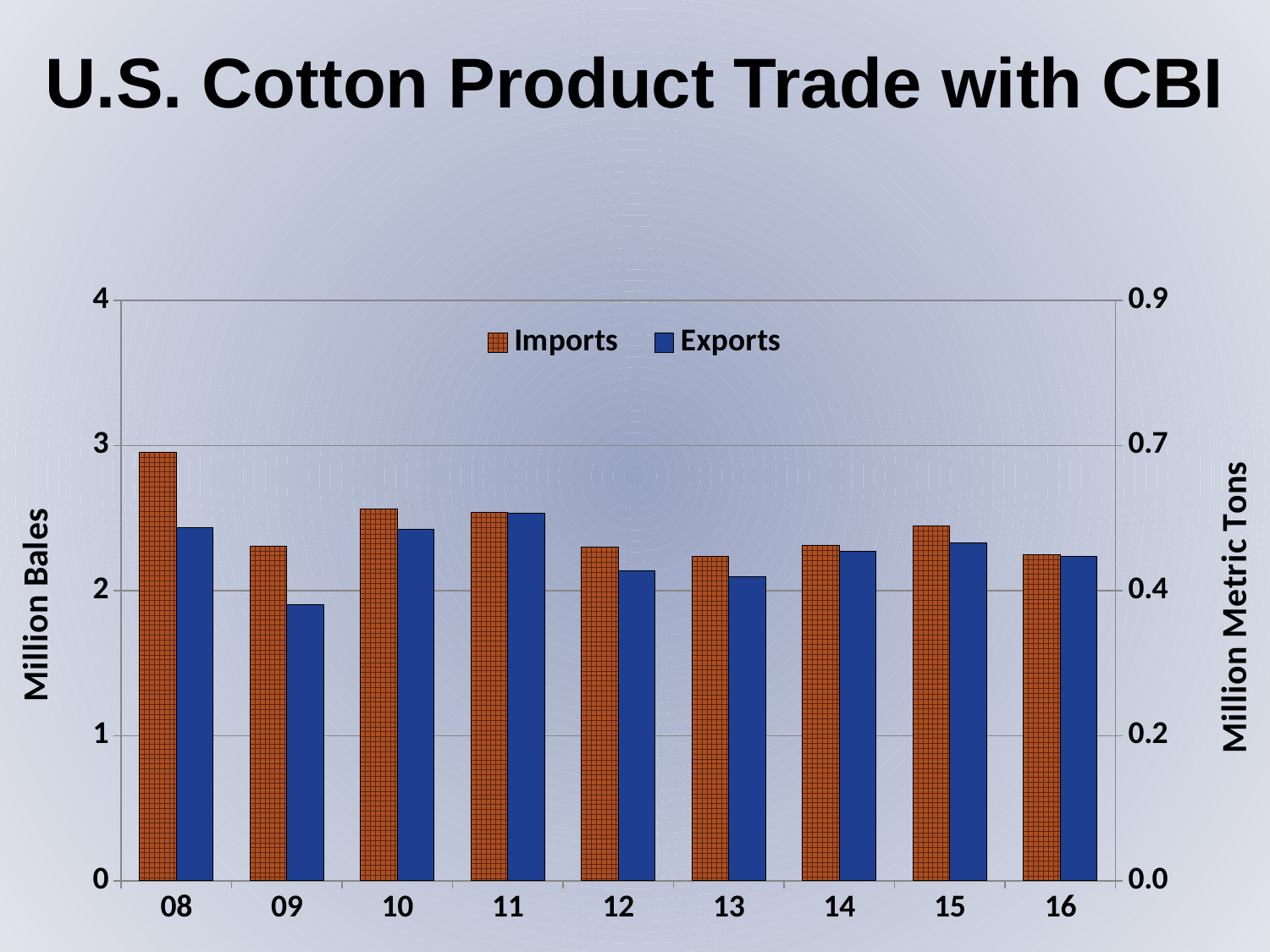
Is the value for Exports in 11 greater or less than 2 million bales? greater In 08, which is larger, Imports or Exports? Imports In which year are Exports lowest? 09 How many years are shown on the x axis? 9 Is the value for Exports in 09 greater or less than 2 million bales? less How many series does the legend list? 2 In which year are Imports highest? 08 What kind of chart is shown on the slide? bar chart In 09, which is larger, Imports or Exports? Imports Is the value for Imports in 08 greater or less than 2 million bales? greater What is the label on the left vertical axis? Million Bales Do Exports rise or fall from 11 to 13? fall